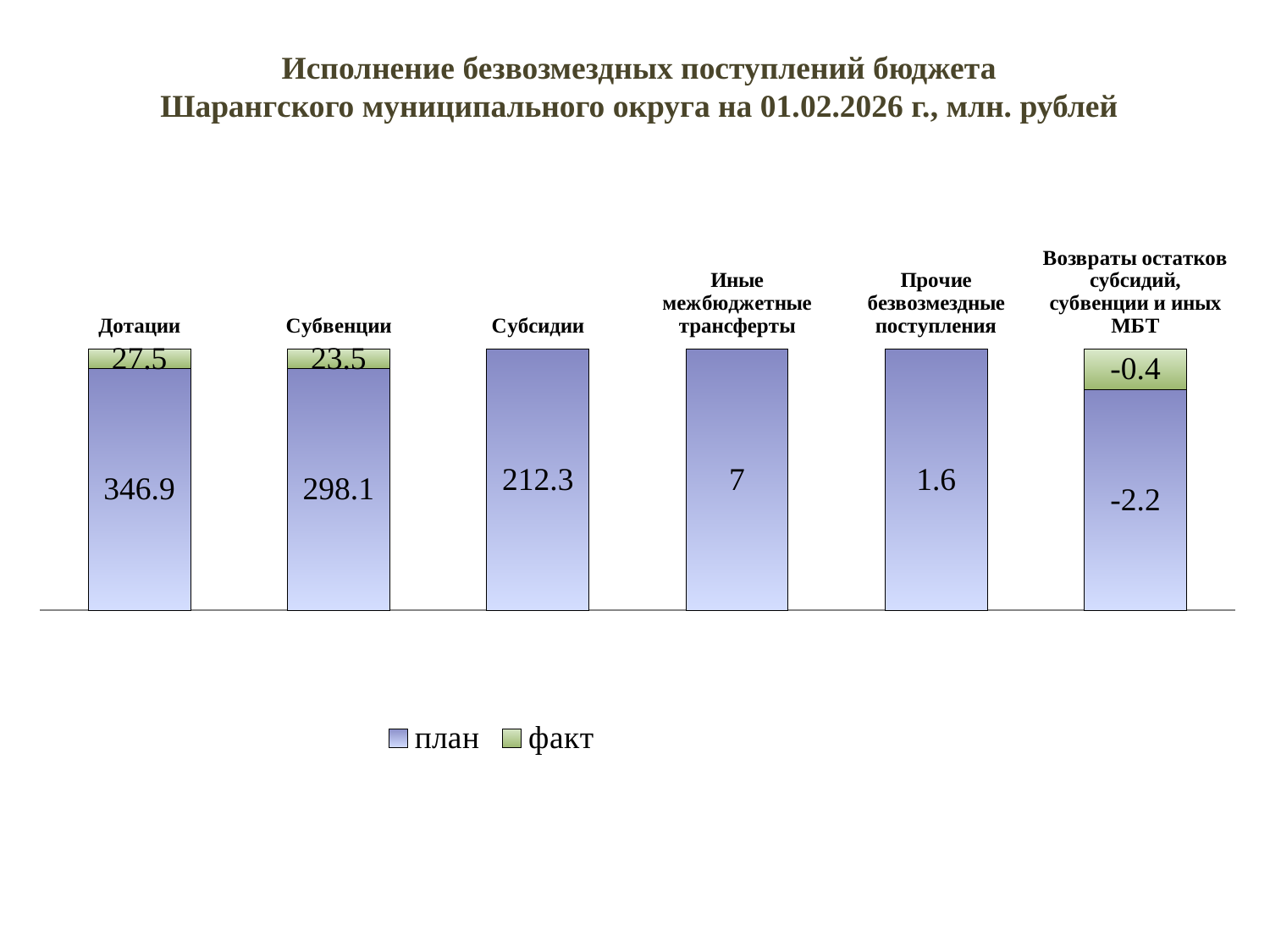
How many series does the legend list? 2 What is the факт value for Субвенции? 23.5 What is the difference between the план values for Дотации and Субвенции? 48.8 How many categories are shown on the x axis? 6 What is the план value for Субсидии? 212.3 What is the план value for Прочие безвозмездные поступления? 1.6 Which is larger, the факт value for Дотации or the факт value for Субвенции? Дотации Which category has the lowest план value? Возвраты остатков субсидий, субвенции и иных МБТ What is the план value for Дотации? 346.9 What is the факт value for Возвраты остатков субсидий, субвенции и иных МБТ? -0.4 What kind of chart is shown on the slide? Stacked bar chart Which category has the highest план value? Дотации